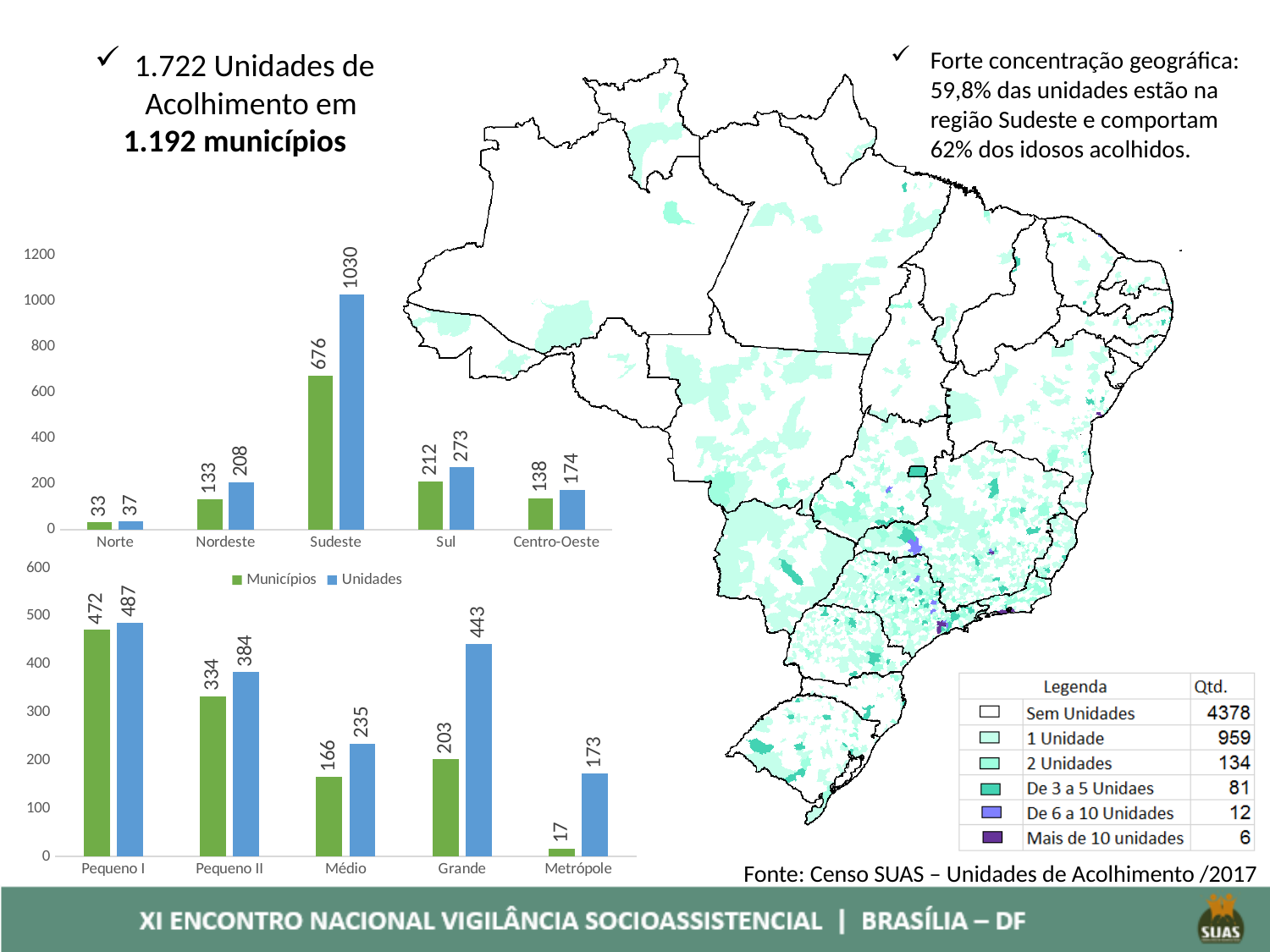
How many series does the legend list for the bar charts? 2 In the top chart by region, what is the value of Municípios for Nordeste? 133 In the top chart by region, what is the difference between Unidades and Municípios for Sul? 61 In the bottom chart by municipality size, what is the value of Municípios for Metrópole? 17 In the top chart by region, what is the value of Unidades for Sudeste? 1030 In the bottom chart by municipality size, which is larger: Unidades for Pequeno II or Unidades for Médio? Pequeno II In the top chart by region, which region has the lowest value of Unidades? Norte What type of chart is the top chart by region? Bar chart In the top chart by region, how many regions are shown on the x axis? 5 In the bottom chart by municipality size, what is the difference between Unidades and Municípios for Grande? 240 In the bottom chart by municipality size, which category has the highest value of Municípios? Pequeno I In the bottom chart by municipality size, what is the value of Unidades for Grande? 443